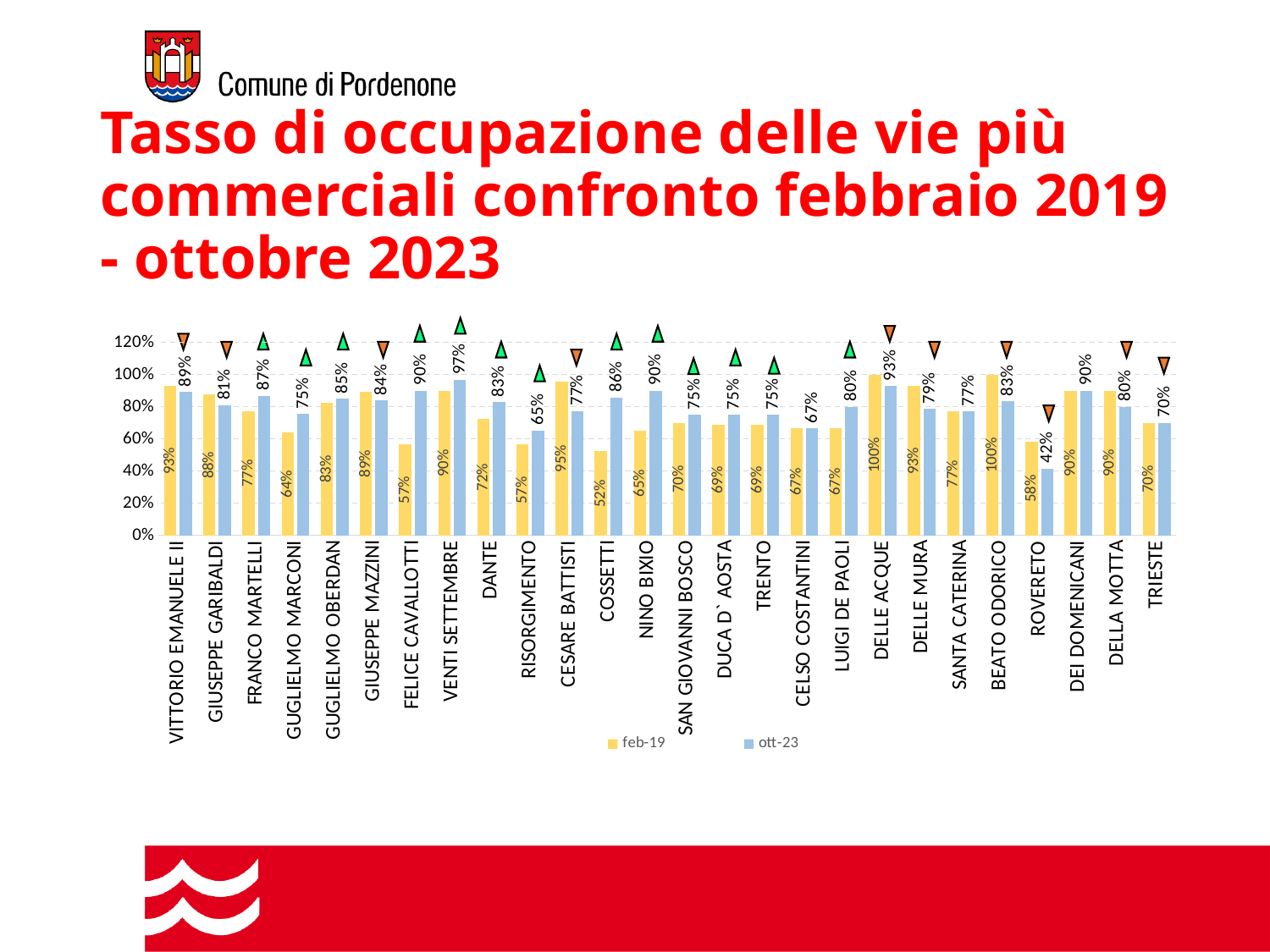
What is the ott-23 value for ROVERETO? 42% Which street has the lowest ott-23 value? ROVERETO How many series does the legend list? 2 Which street has the highest ott-23 value? VENTI SETTEMBRE Which street has the lowest feb-19 value? COSSETTI What kind of chart is shown on the slide? bar chart What is the ott-23 value for VENTI SETTEMBRE? 97% How many streets are shown on the x axis? 26 What is the feb-19 value for COSSETTI? 52% What is the difference between the ott-23 and feb-19 values for FELICE CAVALLOTTI? 33 percentage points Which is larger for DELLE MURA, the feb-19 value or the ott-23 value? feb-19 Is the feb-19 value for GUGLIELMO MARCONI greater or less than 80%? less